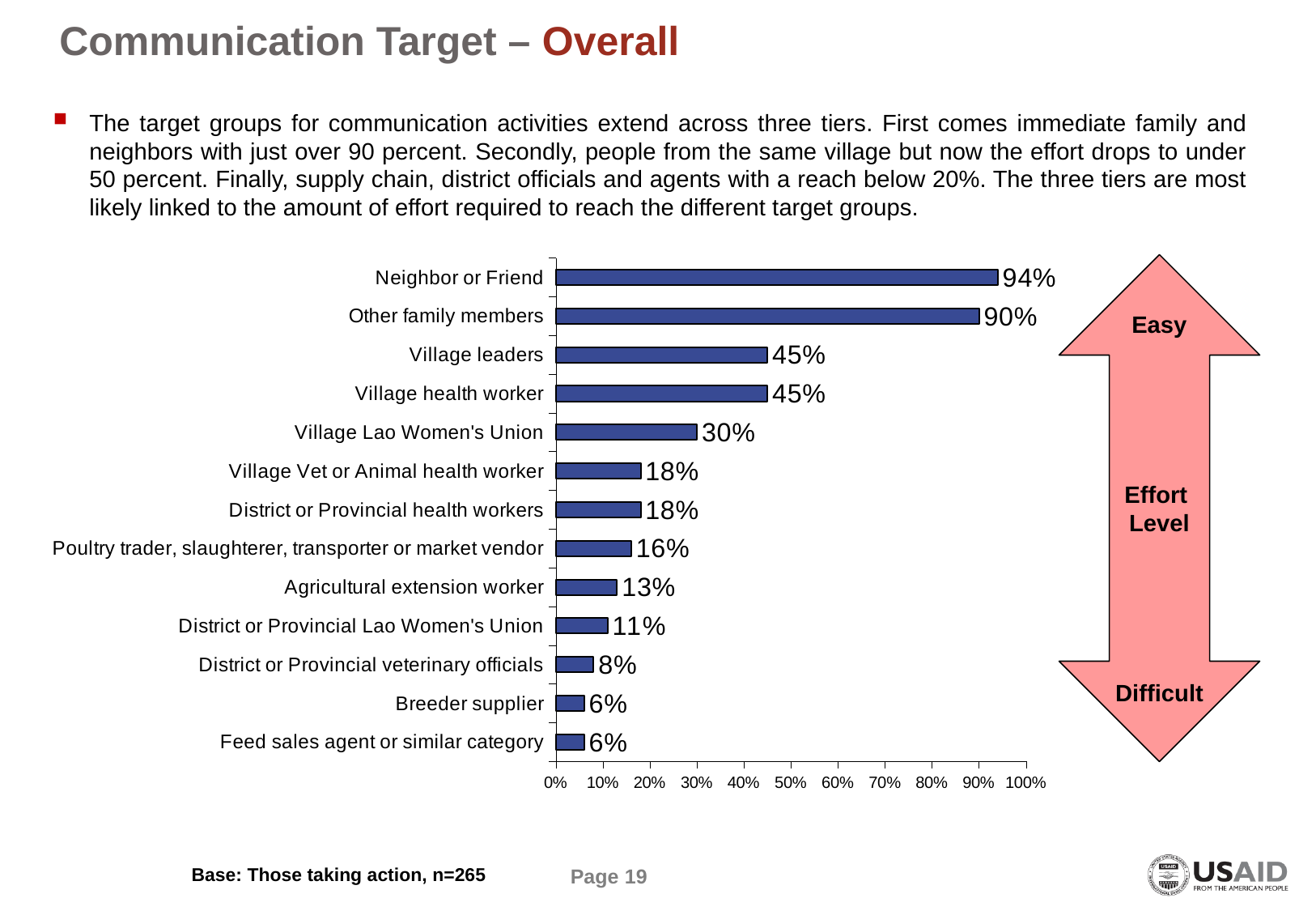
What is the value for Village Lao Women's Union? 30% Is the value for Village health worker greater or less than 40%? greater What kind of chart is shown on the slide? Bar chart What is the value for District or Provincial veterinary officials? 8% What is the value for Neighbor or Friend? 94% Which is larger, Poultry trader, slaughterer, transporter or market vendor or District or Provincial Lao Women's Union? Poultry trader, slaughterer, transporter or market vendor What is the value for Agricultural extension worker? 13% What is the difference between Neighbor or Friend and Other family members? 4% What is the difference between Village leaders and Village Lao Women's Union? 15% What is the base sample size stated below the chart? n=265 Which category has the highest value? Neighbor or Friend How many categories are shown in the chart? 13